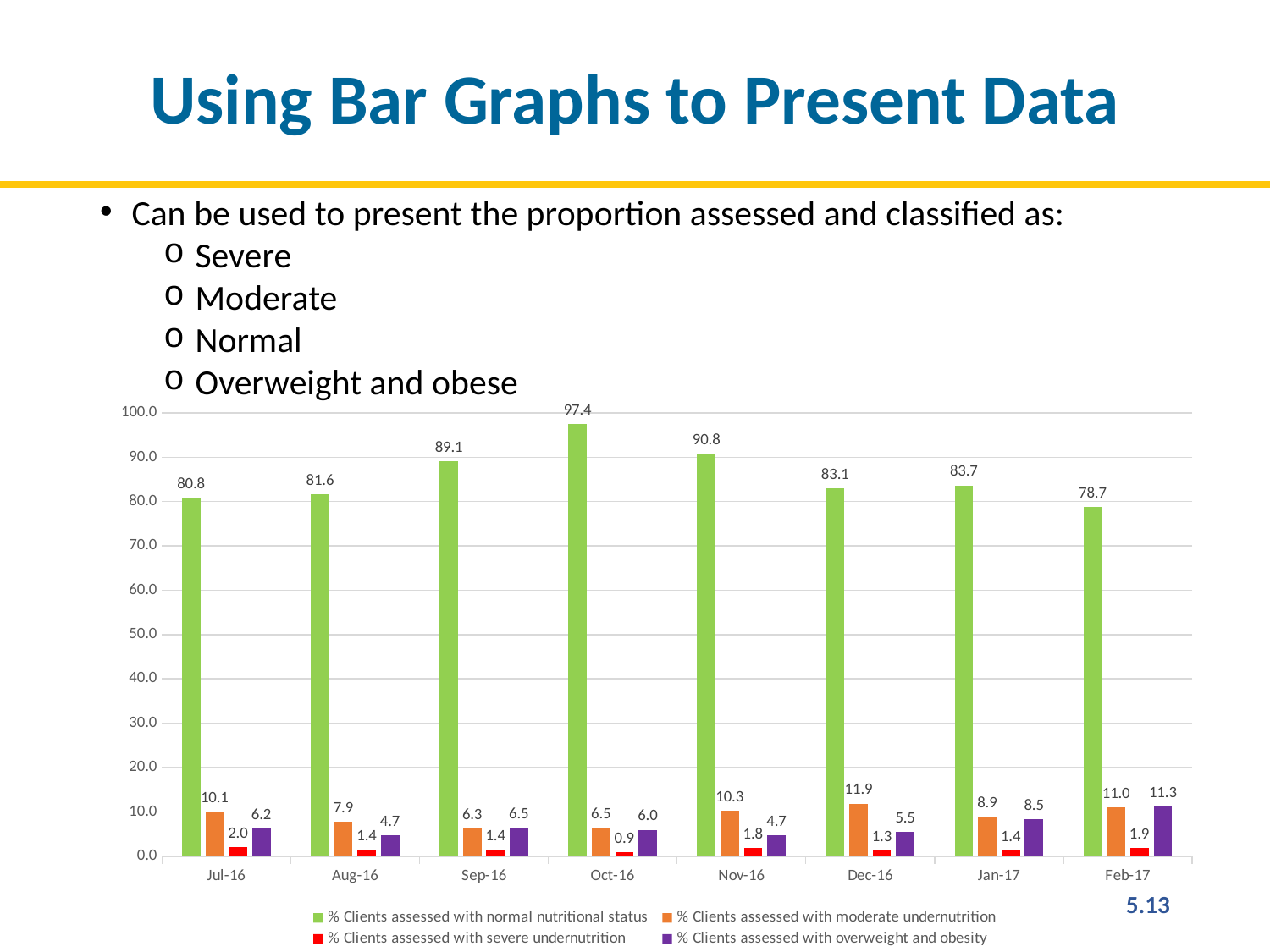
What is the value for % Clients assessed with moderate undernutrition in Dec-16? 11.9 In which month is % Clients assessed with normal nutritional status the highest? Oct-16 How many months are shown on the x axis of the chart? 8 What type of chart is shown on the slide? Bar chart Which is larger in Jan-17: % Clients assessed with moderate undernutrition or % Clients assessed with overweight and obesity? % Clients assessed with moderate undernutrition Is the value for % Clients assessed with normal nutritional status in Sep-16 greater or less than 80.0? greater What is the value for % Clients assessed with normal nutritional status in Oct-16? 97.4 In which month is % Clients assessed with normal nutritional status the lowest? Feb-17 How many series does the chart legend list? 4 In which month is % Clients assessed with overweight and obesity the highest? Feb-17 What is the value for % Clients assessed with severe undernutrition in Jul-16? 2.0 What is the difference between the % Clients assessed with normal nutritional status in Oct-16 and in Feb-17? 18.7